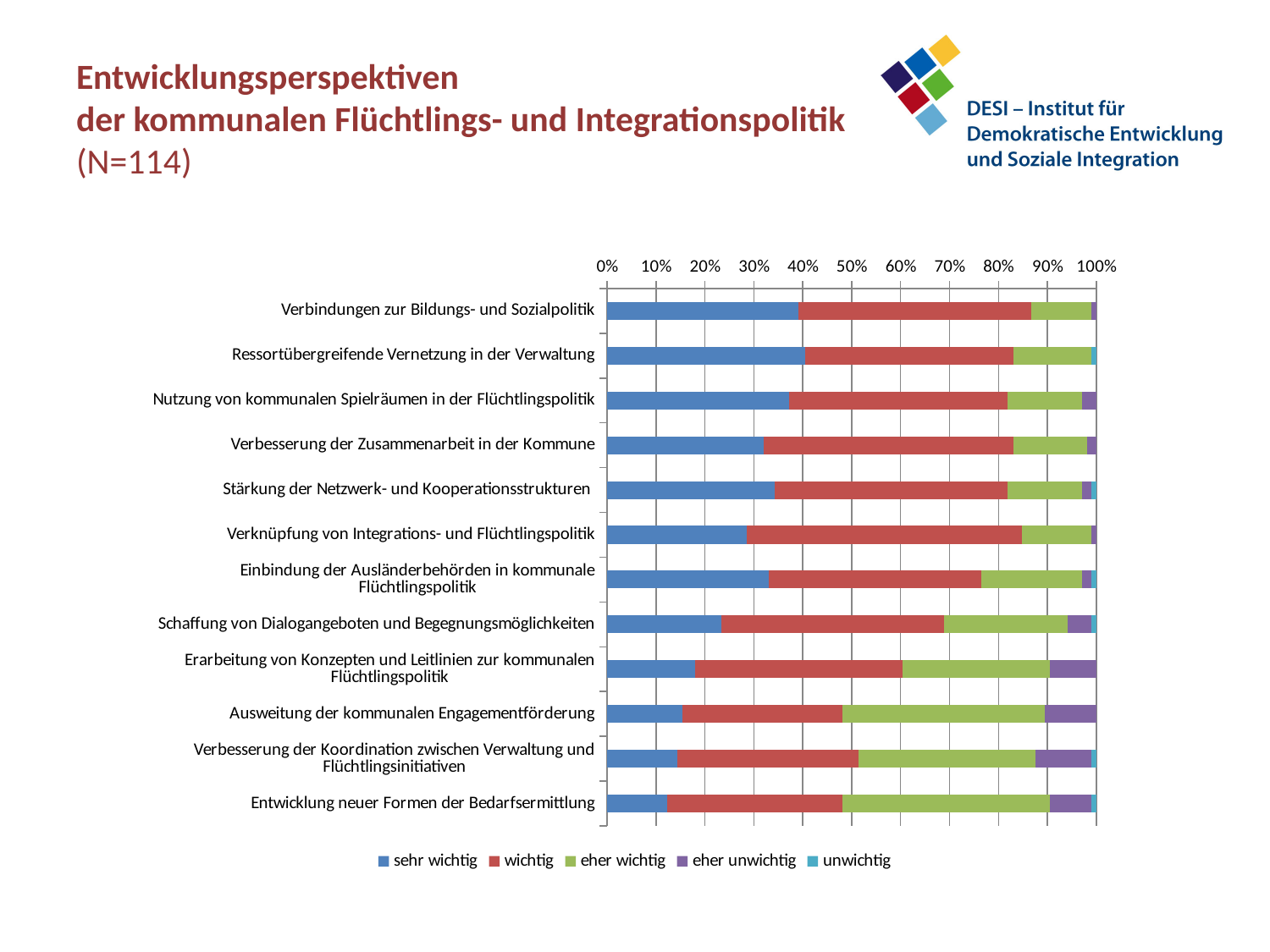
Is the 'eher wichtig' share for 'Ausweitung der kommunalen Engagementförderung' greater or less than 30%? greater How many categories (development perspectives) are plotted in the chart? 12 Is the 'sehr wichtig' share for 'Schaffung von Dialogangeboten und Begegnungsmöglichkeiten' greater or less than 30%? less How many series does the legend list? 5 Which has the larger 'sehr wichtig' share: 'Ressortübergreifende Vernetzung in der Verwaltung' or 'Erarbeitung von Konzepten und Leitlinien zur kommunalen Flüchtlingspolitik'? Ressortübergreifende Vernetzung in der Verwaltung Is the 'sehr wichtig' share for 'Entwicklung neuer Formen der Bedarfsermittlung' greater or less than 20%? less Which series is listed first in the legend? sehr wichtig Which has the larger 'sehr wichtig' share: 'Verbindungen zur Bildungs- und Sozialpolitik' or 'Entwicklung neuer Formen der Bedarfsermittlung'? Verbindungen zur Bildungs- und Sozialpolitik Which has the larger 'eher wichtig' share: 'Ausweitung der kommunalen Engagementförderung' or 'Verbindungen zur Bildungs- und Sozialpolitik'? Ausweitung der kommunalen Engagementförderung What is the highest value shown on the horizontal axis? 100% What kind of chart is shown on the slide? stacked bar chart